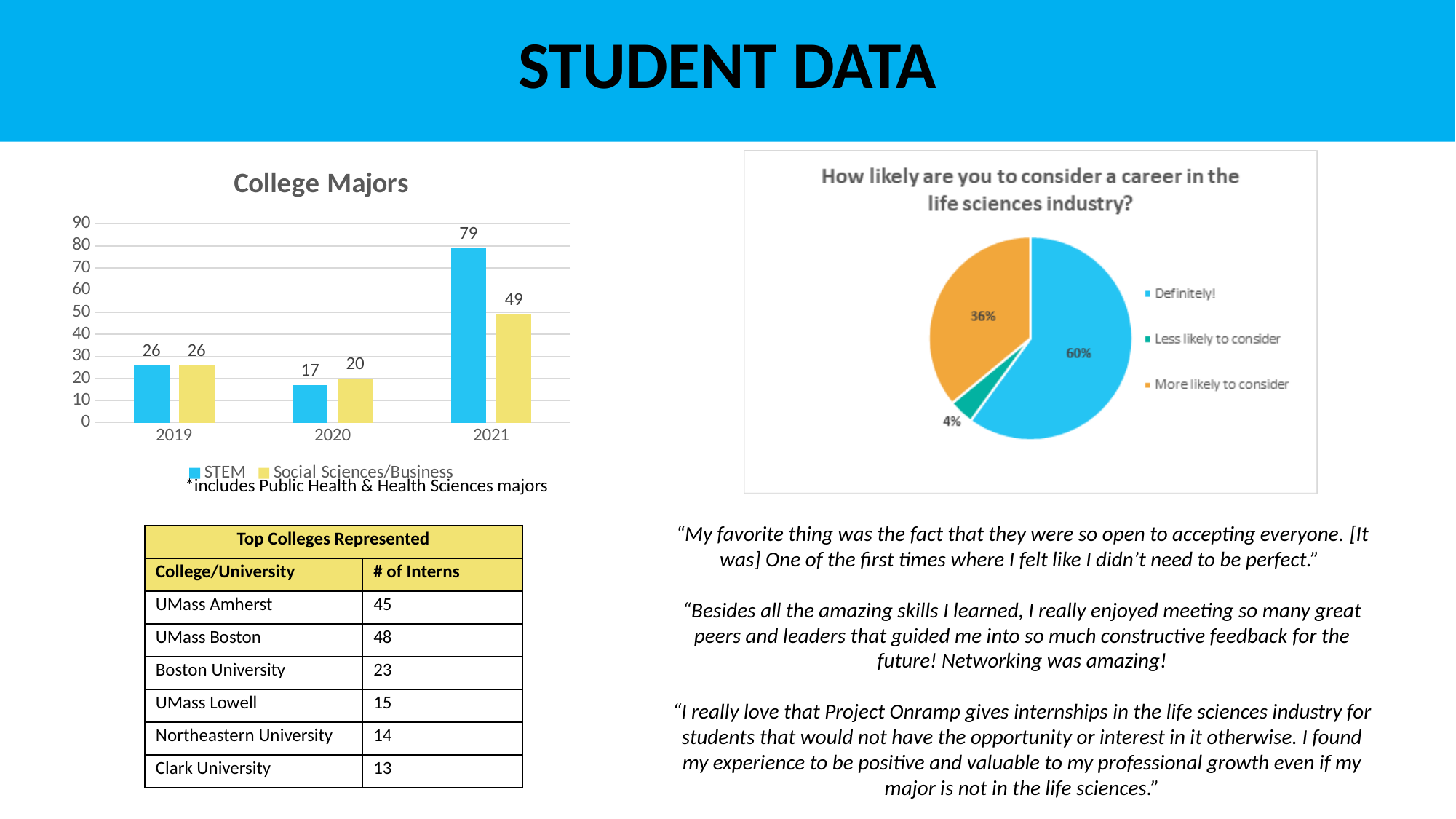
What kind of chart is the College Majors chart? bar chart In the College Majors chart, what is the value for STEM in 2021? 79 In the College Majors chart, which year has the lowest STEM value? 2020 In the pie chart titled 'How likely are you to consider a career in the life sciences industry?', how many categories does the legend list? 3 In the College Majors chart, what is the value for Social Sciences/Business in 2020? 20 In the pie chart titled 'How likely are you to consider a career in the life sciences industry?', which category has the smallest share? Less likely to consider In the College Majors chart, which is larger in 2020: STEM or Social Sciences/Business? Social Sciences/Business In the College Majors chart, how many years are shown on the x axis? 3 In the College Majors chart, what is the difference between the STEM and Social Sciences/Business values in 2021? 30 In the pie chart titled 'How likely are you to consider a career in the life sciences industry?', what share is 'Definitely!'? 60% In the College Majors chart, which year has the highest STEM value? 2021 In the College Majors chart, how many series does the legend list? 2